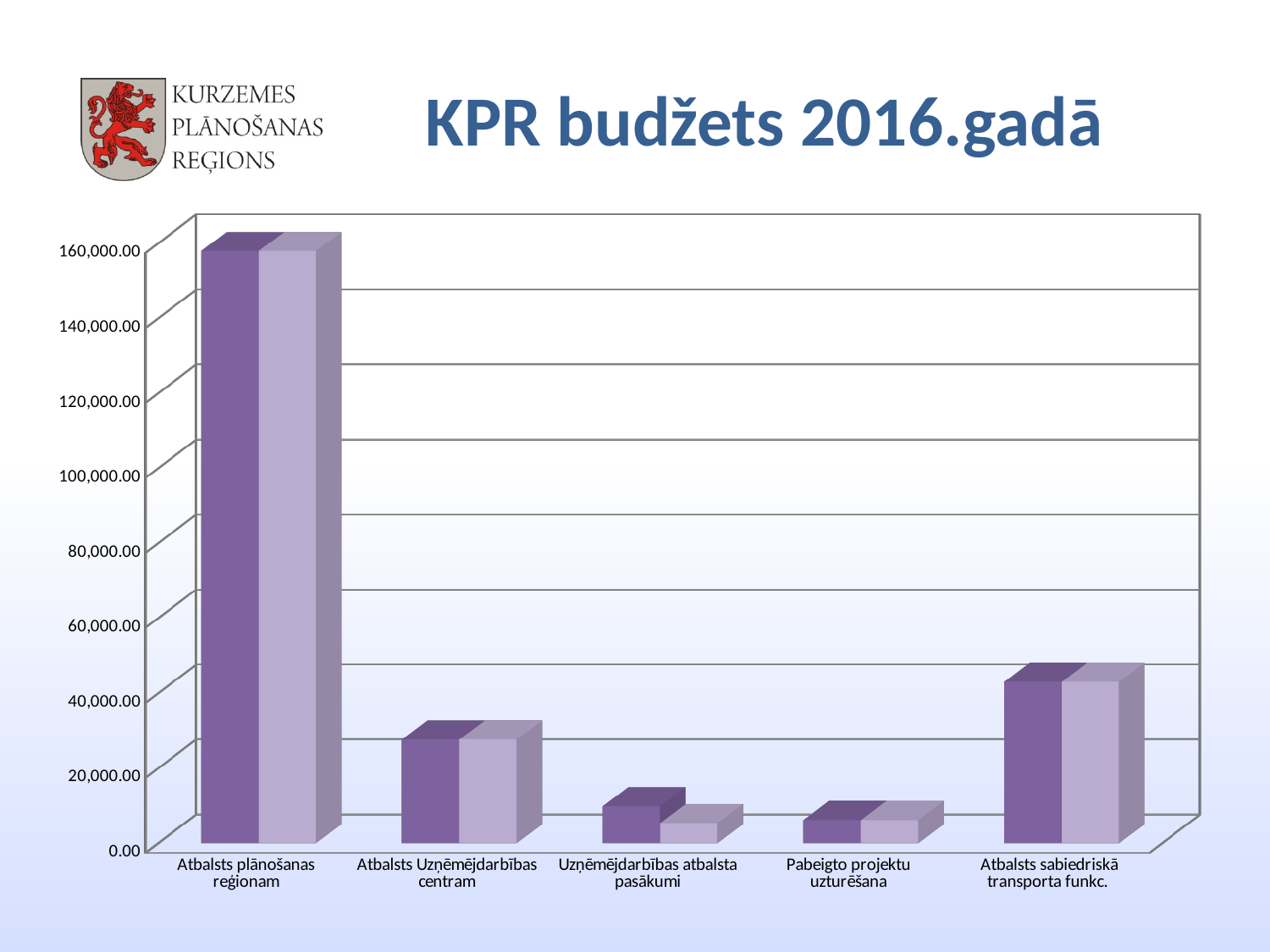
How many categories are shown on the x axis of the chart? 5 What kind of chart is shown on the slide? Bar chart Which category has the highest value in the chart? Atbalsts plānošanas reģionam Is the value for Uzņēmējdarbības atbalsta pasākumi greater or less than 20,000.00? less What is the title of the slide containing the chart? KPR budžets 2016.gadā Is the value for Atbalsts plānošanas reģionam greater or less than 140,000.00? greater Is the value for Atbalsts Uzņēmējdarbības centram greater or less than 40,000.00? less Which is larger, the value for Atbalsts Uzņēmējdarbības centram or the value for Atbalsts sabiedriskā transporta funkc.? Atbalsts sabiedriskā transporta funkc. Which is larger, the value for Atbalsts plānošanas reģionam or the value for Atbalsts sabiedriskā transporta funkc.? Atbalsts plānošanas reģionam